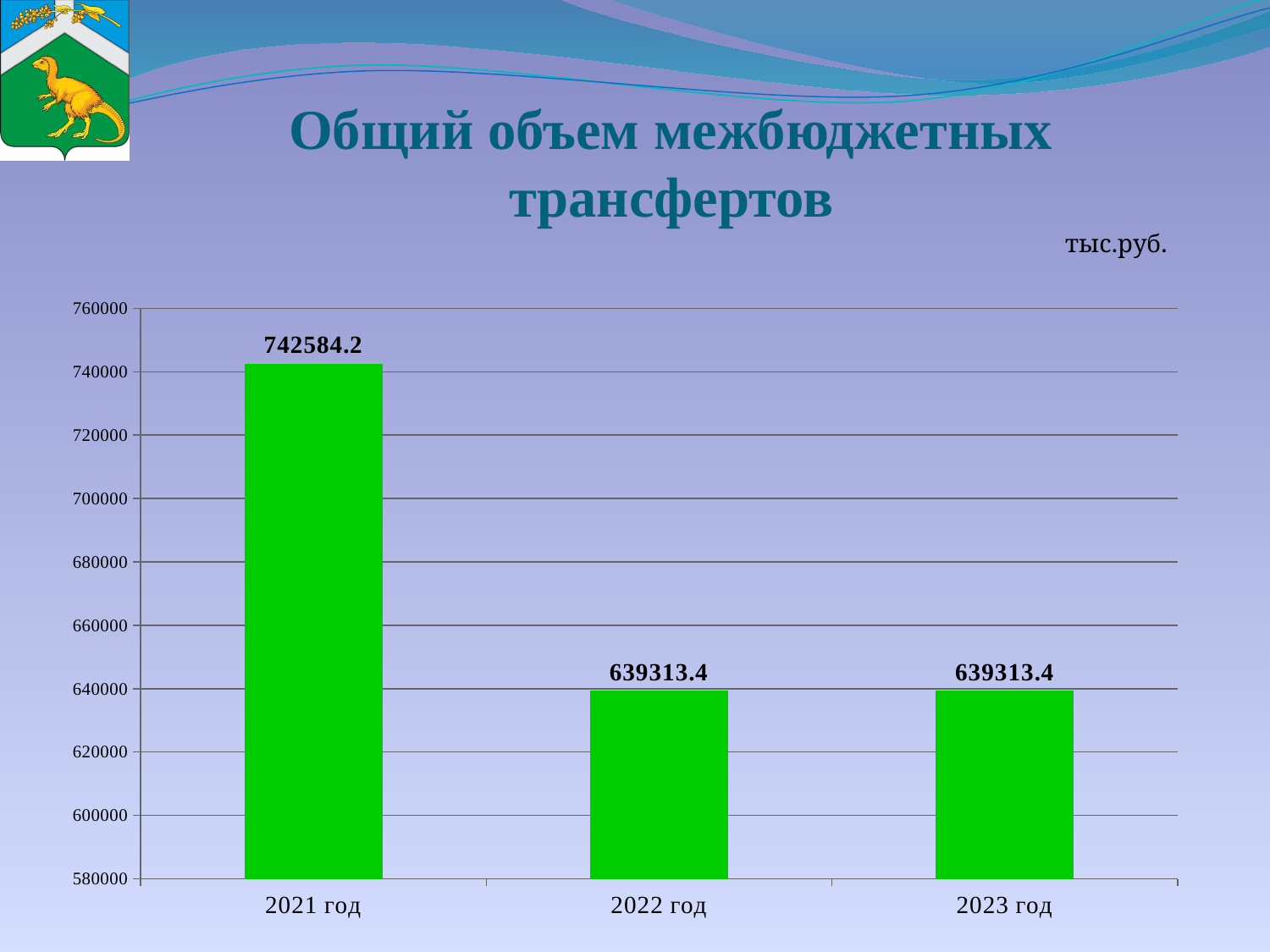
What unit is indicated above the chart? тыс.руб. Which year has the highest value? 2021 год What kind of chart is shown on the slide? bar chart What is the value for 2021 год? 742584.2 Do the values rise or fall from 2021 год to 2022 год? fall Is the value for 2021 год greater or less than 720000? greater Is the value for 2022 год greater or less than 660000? less What is the difference between the values for 2021 год and 2022 год? 103270.8 Which is larger, the value for 2021 год or the value for 2023 год? 2021 год How many years are shown on the chart? 3 What is the value for 2022 год? 639313.4 What is the value for 2023 год? 639313.4